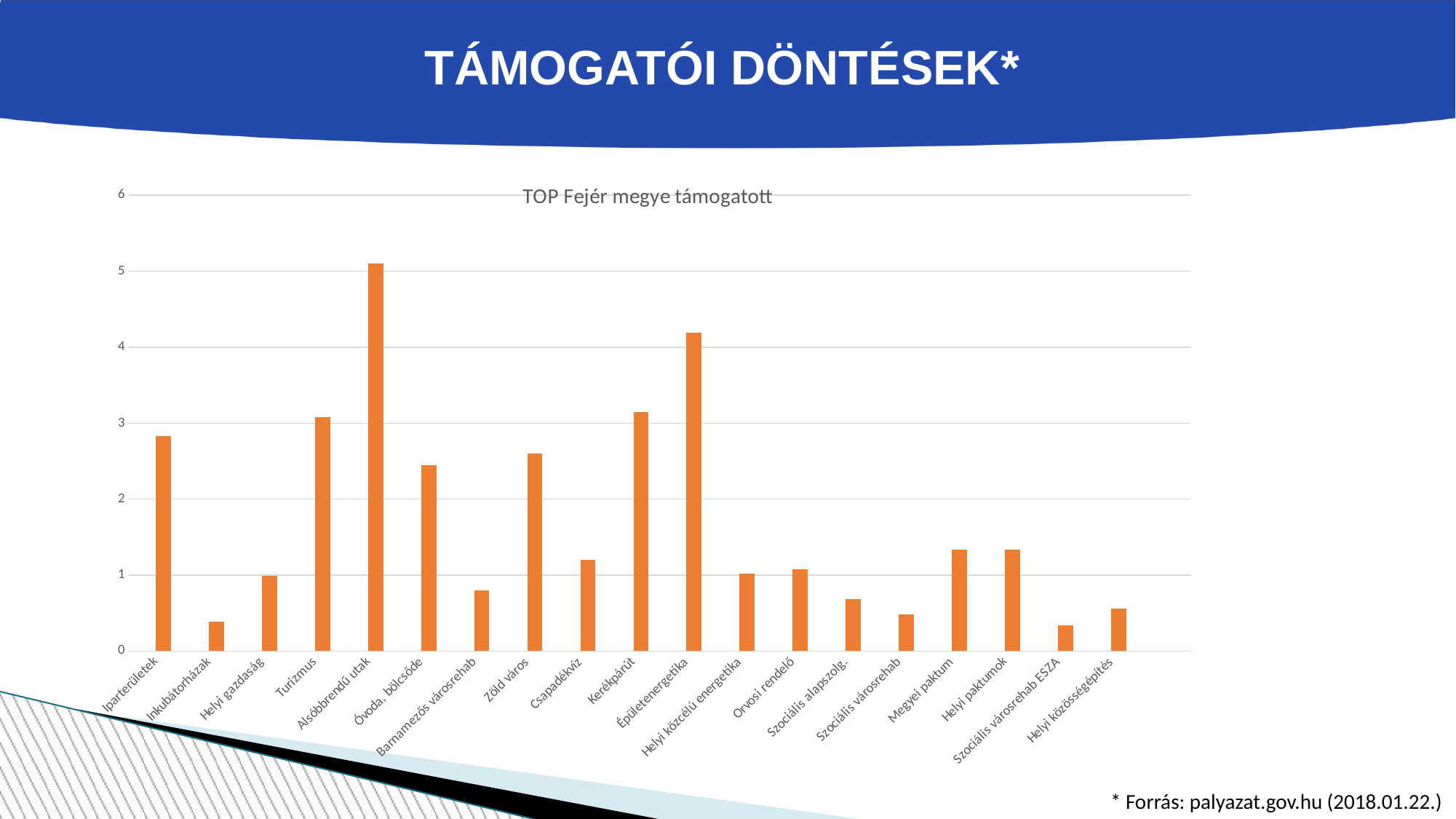
Is the value for Kerékpárút greater or less than 3? greater Which category has the highest bar in the chart? Alsóbbrendű utak Which is larger, the value for Turizmus or the value for Csapadékvíz? Turizmus Is the value for Iparterületek greater or less than 3? less How many categories are plotted on the x axis of the chart? 19 Which is larger, the value for Alsóbbrendű utak or the value for Épületenergetika? Alsóbbrendű utak Is the value for Alsóbbrendű utak greater or less than 5? greater What is the title of the chart? TOP Fejér megye támogatott What kind of chart is shown on the slide? bar chart